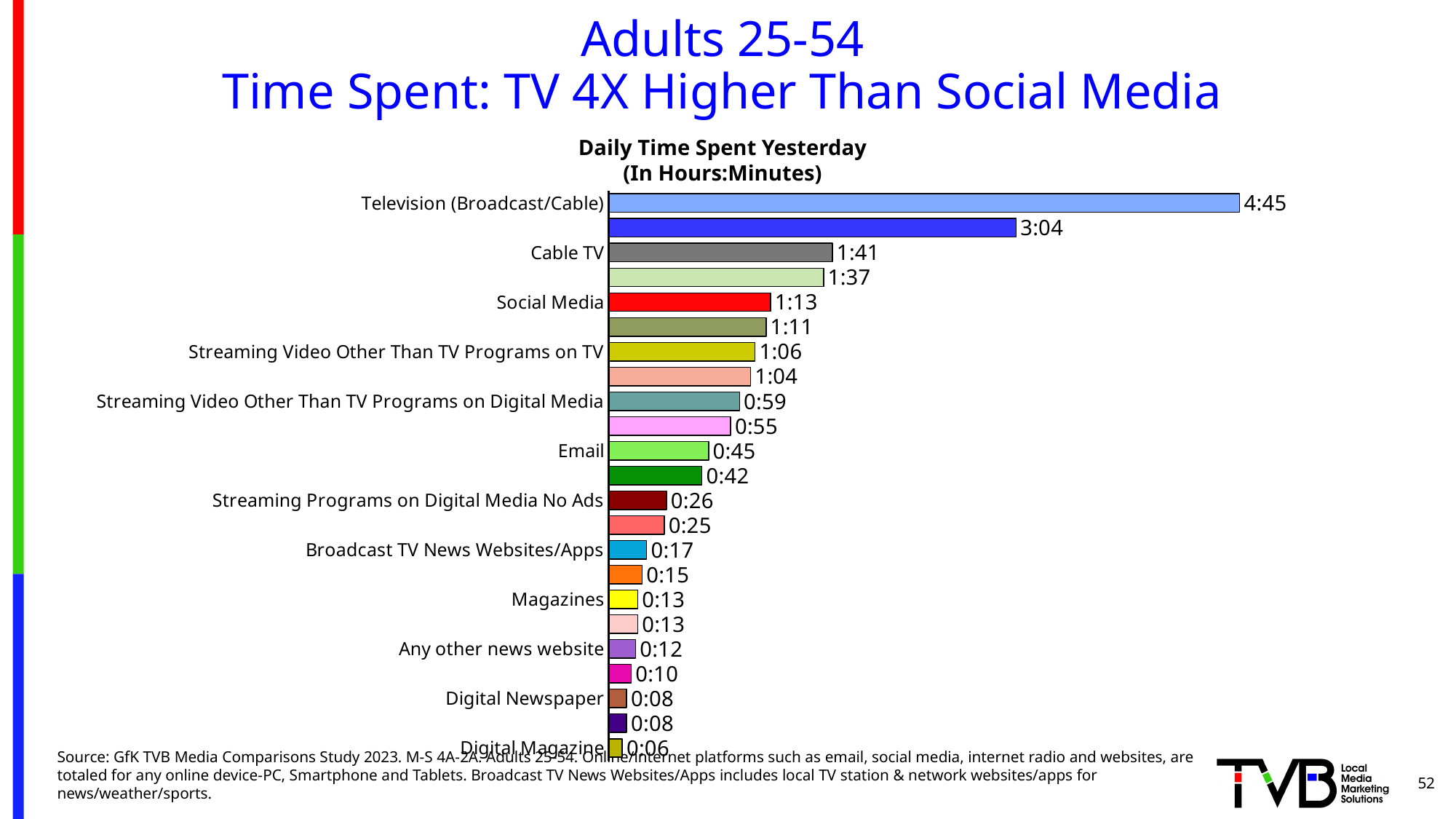
What is the daily time spent for Broadcast TV News Websites/Apps? 0:17 What is the title of the chart? Daily Time Spent Yesterday (In Hours:Minutes) What is the daily time spent for Cable TV? 1:41 What type of chart is shown on the slide? Bar chart What is the daily time spent for Television (Broadcast/Cable)? 4:45 Which has a higher daily time spent, Magazines or Digital Newspaper? Magazines Which category has the lowest daily time spent? Digital Magazine What is the daily time spent for Social Media? 1:13 How much more daily time is spent on Cable TV than on Email? 0:56 How much more daily time is spent on Television (Broadcast/Cable) than on Social Media? 3:32 What is the daily time spent for Email? 0:45 Which category has the highest daily time spent? Television (Broadcast/Cable)